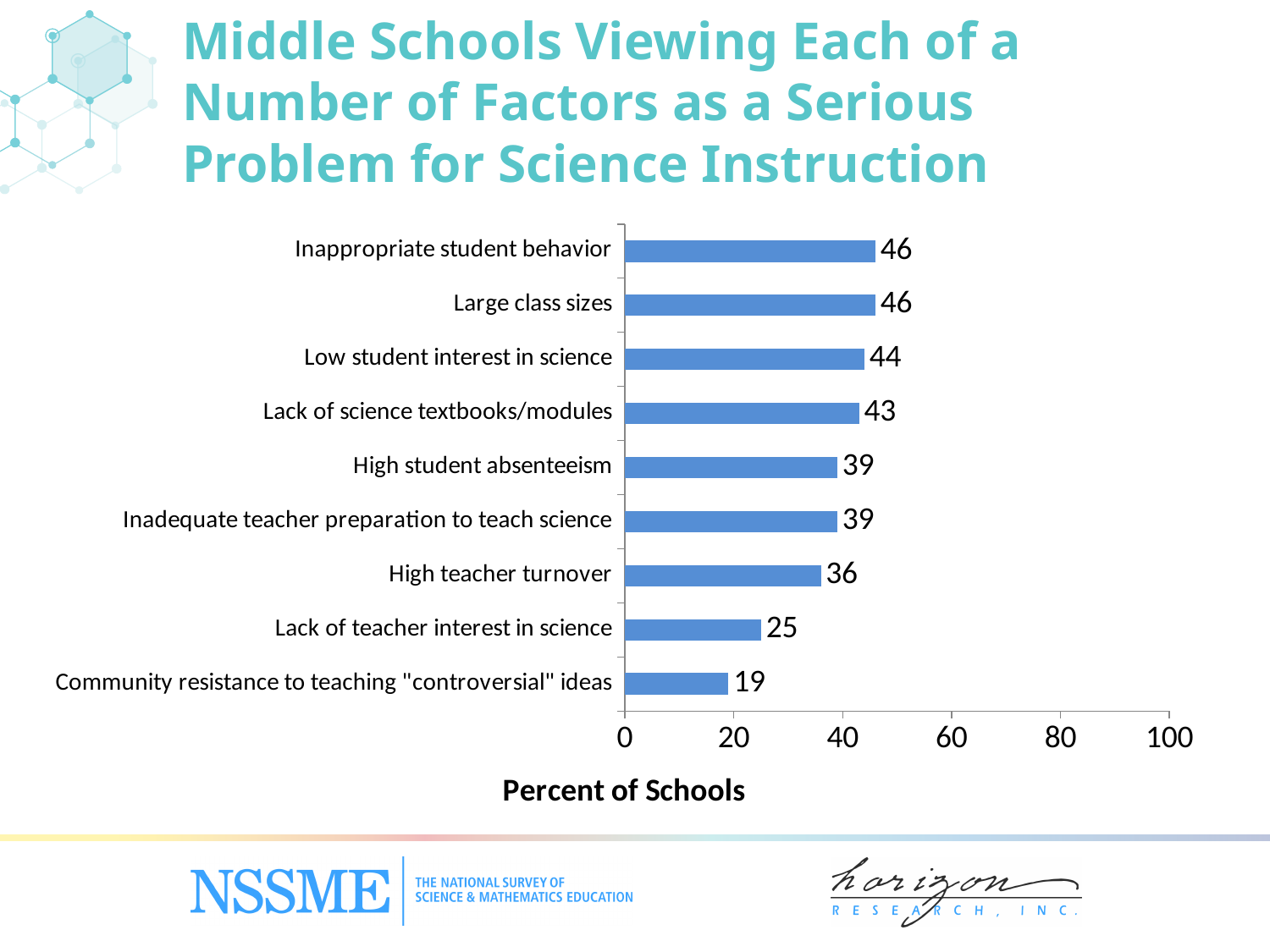
Which factor has the lowest percent of schools viewing it as a serious problem? Community resistance to teaching "controversial" ideas Is the value for "Inappropriate student behavior" greater or less than 40? greater What is the value for "Lack of teacher interest in science"? 25 Which is larger, the value for "High teacher turnover" or the value for "Lack of teacher interest in science"? High teacher turnover What is the difference between the values for "Low student interest in science" and "Community resistance to teaching "controversial" ideas"? 25 What percent of middle schools view high teacher turnover as a serious problem for science instruction? 36 What is the value for "Lack of science textbooks/modules"? 43 How many factors are shown in the chart? 9 What is the label of the horizontal axis? Percent of Schools What kind of chart is shown on the slide? bar chart What is the difference between the values for "Large class sizes" and "High student absenteeism"? 7 What is the highest value shown on the horizontal axis? 100